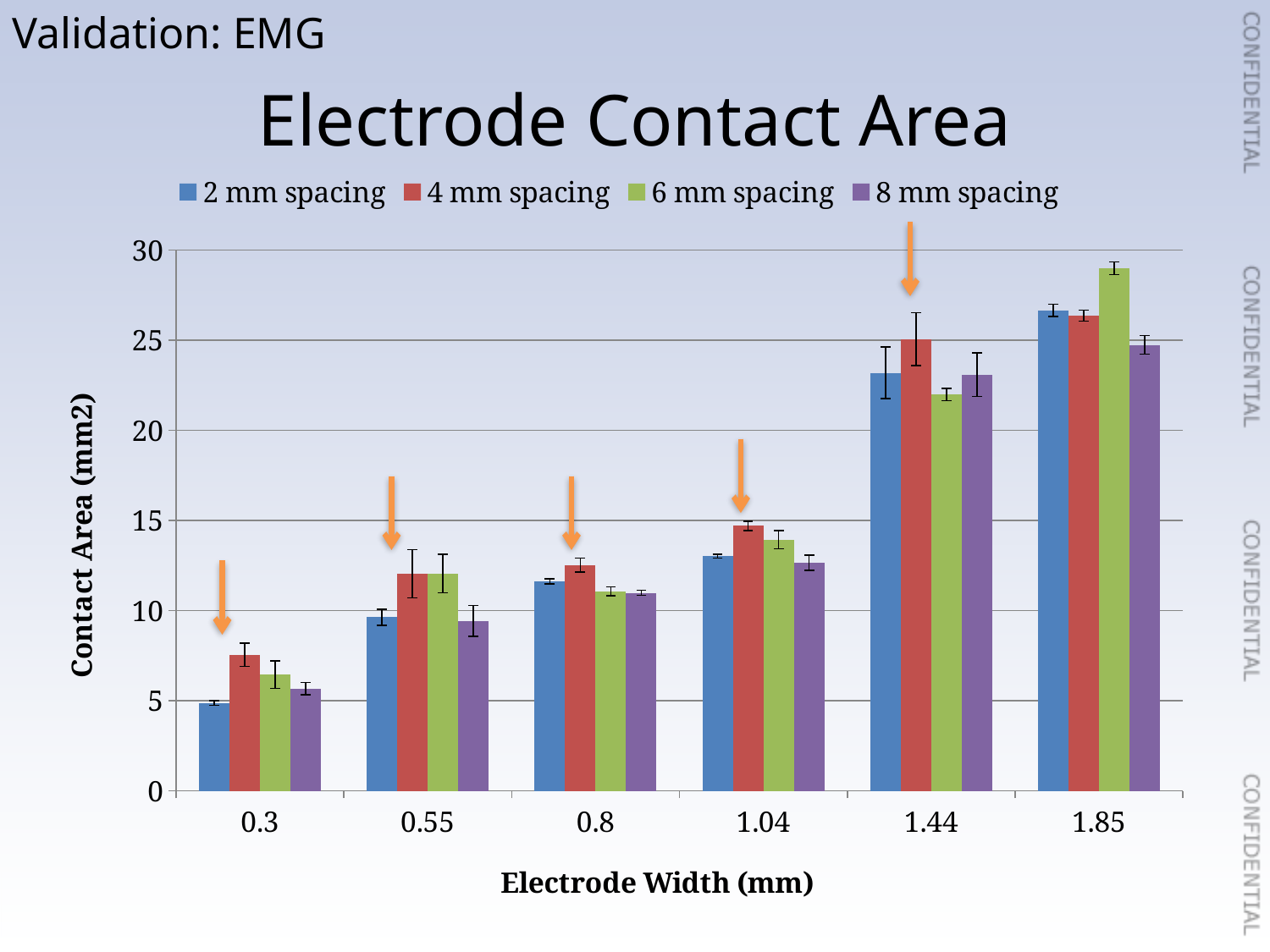
At electrode width 1.85, which spacing has the highest contact area? 6 mm spacing Do the values for 2 mm spacing rise or fall as electrode width increases along the x axis? rise Is the value for 4 mm spacing at electrode width 1.44 greater or less than 20? greater How many series does the legend list? 4 What is the title of the x axis? Electrode Width (mm) What is the title of the y axis? Contact Area (mm2) At electrode width 0.3, which spacing has the lowest contact area? 2 mm spacing Is the value for 6 mm spacing at electrode width 1.85 greater or less than 25? greater At electrode width 1.04, which is larger: the value for 4 mm spacing or 8 mm spacing? 4 mm spacing How many electrode width categories are shown on the x axis? 6 Is the value for 8 mm spacing at electrode width 0.55 greater or less than 10? less What kind of chart is shown on the slide? Bar chart